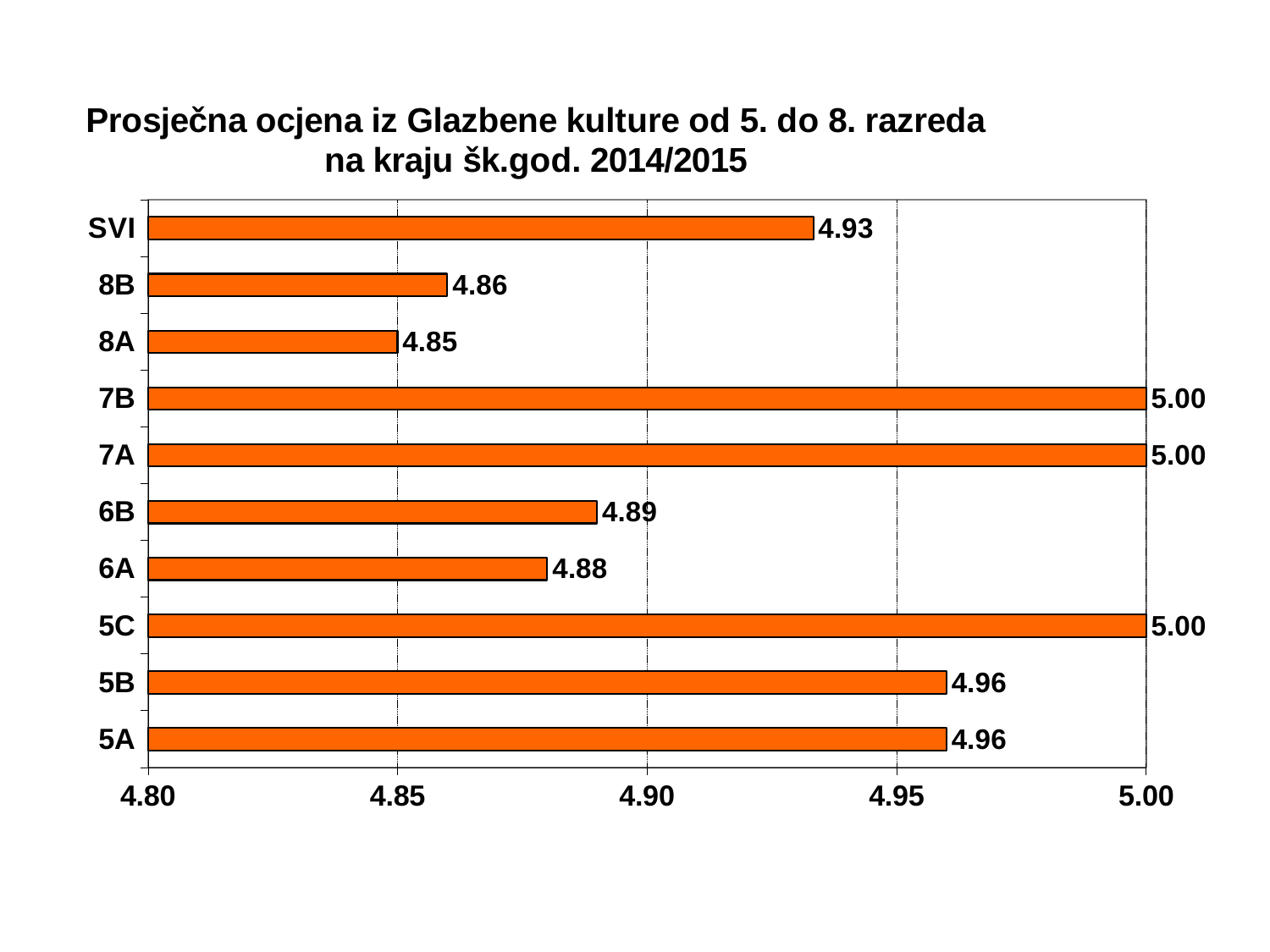
What is the average grade for 8A? 4.85 What is the average grade for 6B? 4.89 What is the value shown for SVI? 4.93 Is the value for 5B greater or less than 4.90? greater What is the difference between the values for SVI and 6A? 0.05 Which is larger, the value for 6B or the value for 8B? 6B How many categories have a value of 5.00? 3 What kind of chart is shown on the slide? bar chart What is the difference between the values for 5A and 8B? 0.10 How many categories are shown on the chart? 10 Which category has the lowest average grade? 8A What is the title of the chart? Prosječna ocjena iz Glazbene kulture od 5. do 8. razreda na kraju šk.god. 2014/2015